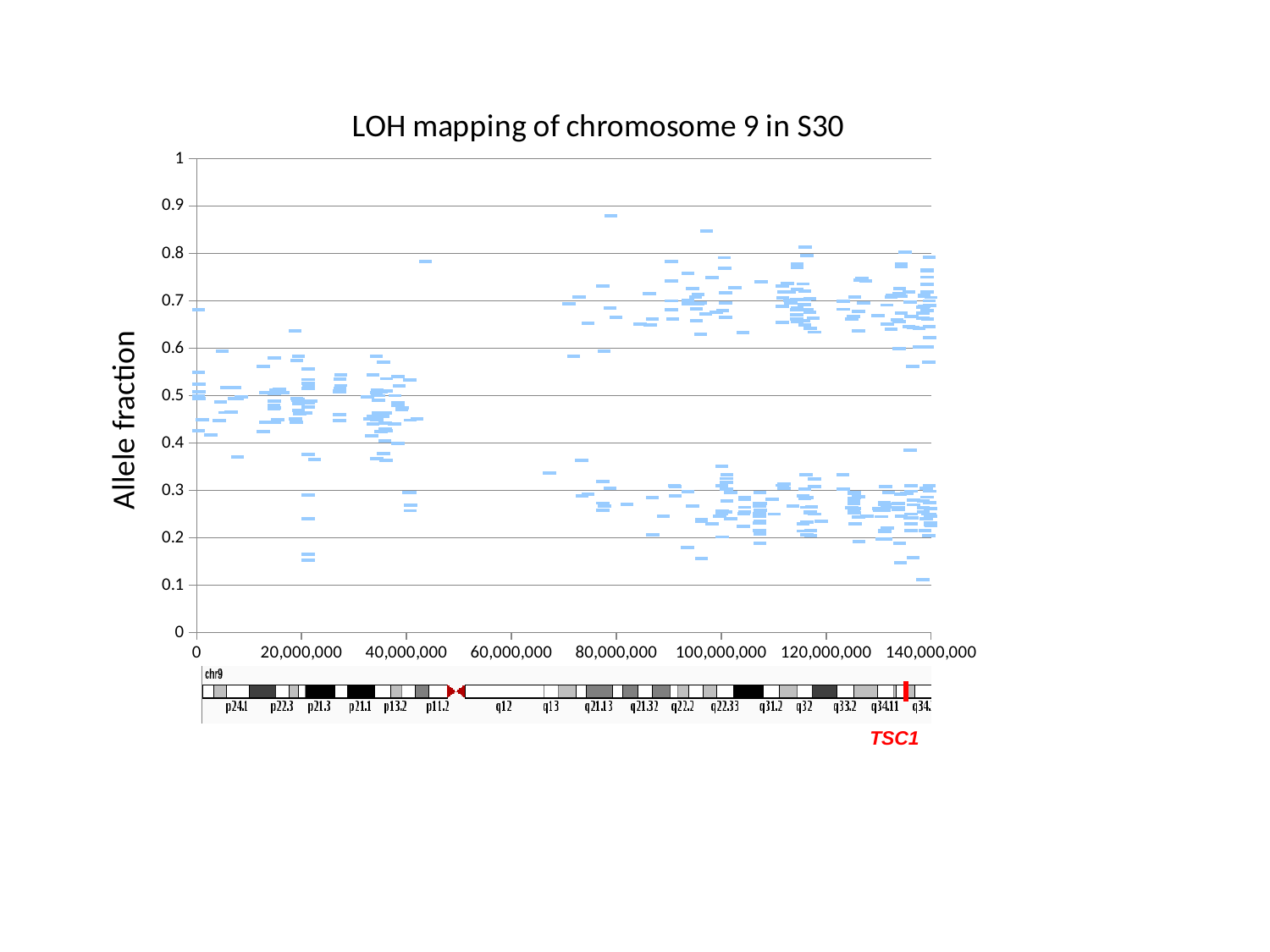
What is the largest tick label shown on the horizontal axis? 140,000,000 Is the highest plotted point on the chart greater or less than 0.8? greater What is the interval between consecutive tick labels on the horizontal axis? 20,000,000 Is the lowest plotted point on the chart greater or less than 0.2? less What kind of chart is shown on the slide? scatter chart How many tick labels are shown on the vertical axis? 11 What is the highest value shown on the vertical axis? 1 What is the title of the chart? LOH mapping of chromosome 9 in S30 What is the interval between consecutive tick labels on the vertical axis? 0.1 What is the label on the vertical axis of the chart? Allele fraction